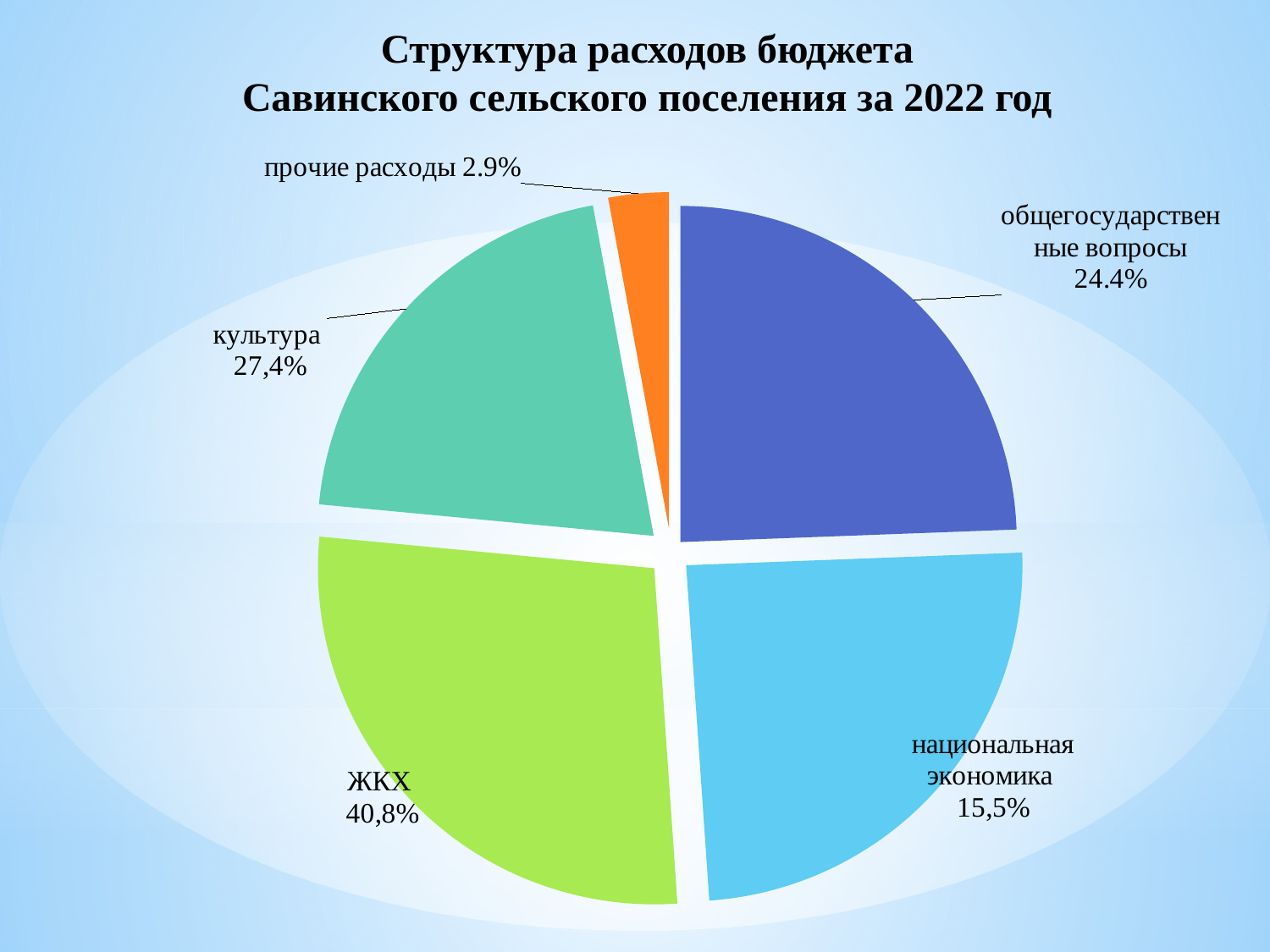
Which category has the largest share of the budget expenditure? ЖКХ What share of the budget expenditure goes to общегосударственные вопросы? 24.4% What is the title of the chart? Структура расходов бюджета Савинского сельского поселения за 2022 год What kind of chart is shown on the slide? pie chart How many categories does the pie chart show? 5 What share of the budget expenditure goes to национальная экономика? 15,5% What share of the budget expenditure goes to ЖКХ? 40,8% Which category has the smallest share of the budget expenditure? прочие расходы What share of the budget expenditure goes to культура? 27,4% What share of the budget expenditure goes to прочие расходы? 2.9% By how many percentage points does the share for ЖКХ exceed the share for культура? 13,4%